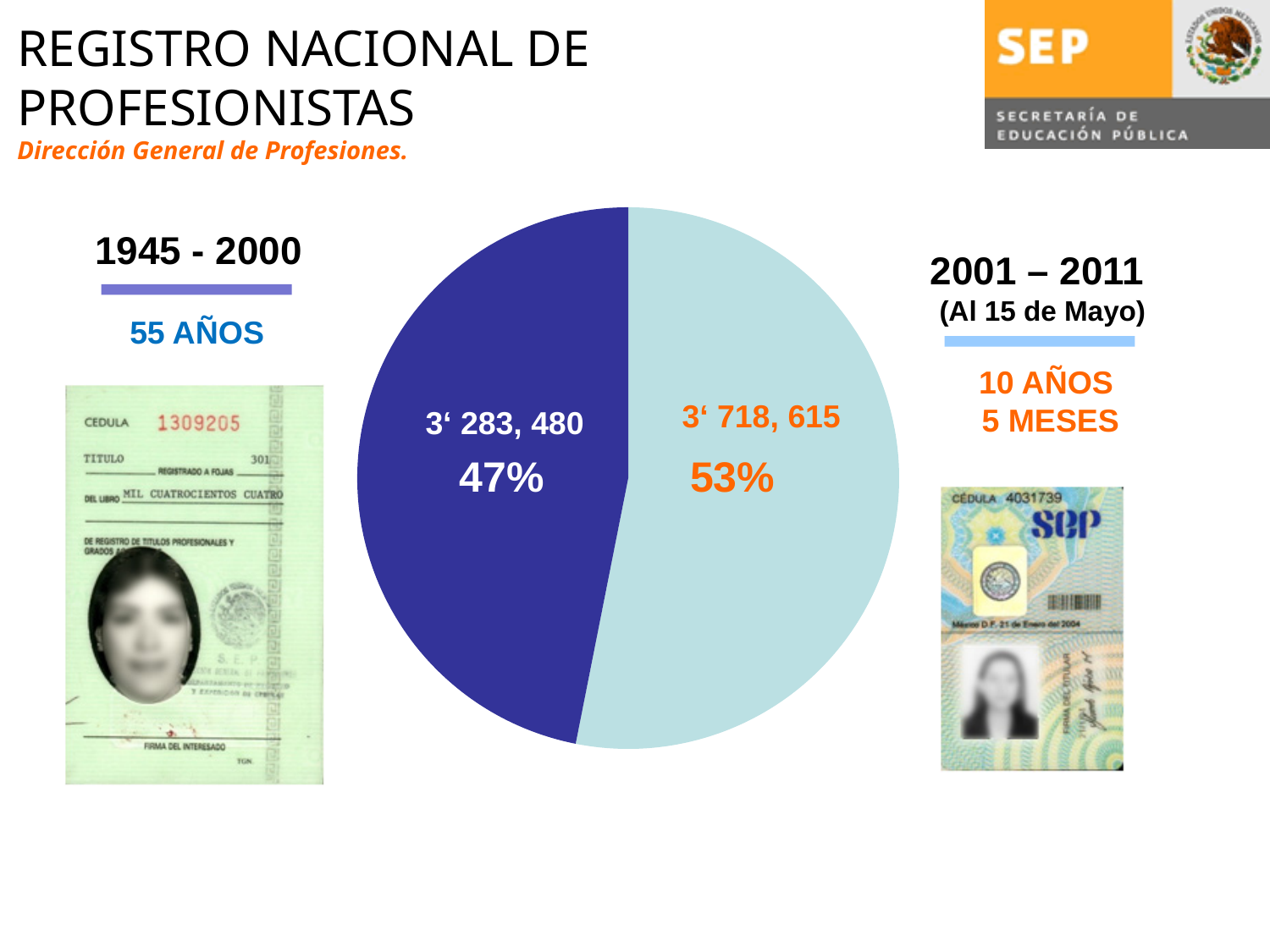
How many slices does the pie chart have? 2 What colour is the slice for the 1945 - 2000 period? dark blue What share of the pie does the 1945 - 2000 period represent? 47% Which period has the larger slice of the pie chart? 2001 – 2011 What kind of chart is shown on the slide? pie chart What colour is the slice for the 2001 – 2011 period? light blue What value is shown for the 2001 – 2011 slice of the pie chart? 3' 718, 615 By how many percentage points does the 2001 – 2011 share exceed the 1945 - 2000 share? 6 Is the value for 2001 – 2011 larger or smaller than the value for 1945 - 2000? larger What value is shown for the 1945 - 2000 slice of the pie chart? 3' 283, 480 Which period has the smaller slice of the pie chart? 1945 - 2000 What share of the pie does the 2001 – 2011 period represent? 53%